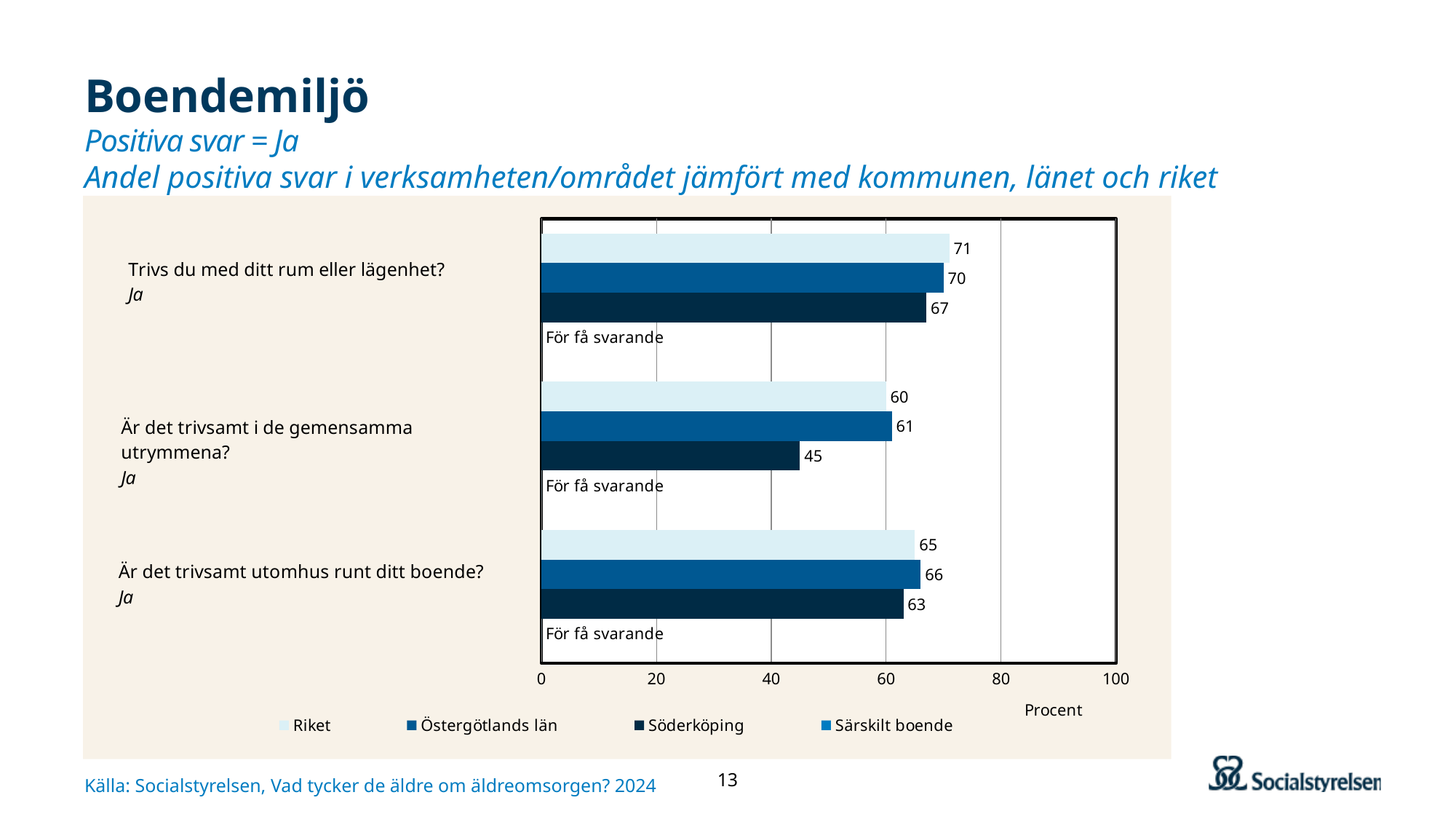
Is the value for Söderköping on "Är det trivsamt i de gemensamma utrymmena?" greater or less than 60? less What is the value for Östergötlands län on "Är det trivsamt utomhus runt ditt boende?"? 66 What is the difference between Östergötlands län and Söderköping on "Är det trivsamt i de gemensamma utrymmena?"? 16 How many question categories are shown on the chart? 3 What is the value for Söderköping on "Är det trivsamt i de gemensamma utrymmena?"? 45 What kind of chart is shown on the slide? Bar chart Which series has the highest value on "Trivs du med ditt rum eller lägenhet?"? Riket Which is larger on "Är det trivsamt utomhus runt ditt boende?": Riket or Söderköping? Riket What is the value for Riket on "Trivs du med ditt rum eller lägenhet?"? 71 Which series has the lowest value on "Är det trivsamt i de gemensamma utrymmena?"? Söderköping What is shown for Särskilt boende on "Trivs du med ditt rum eller lägenhet?"? För få svarande How many series does the legend list? 4